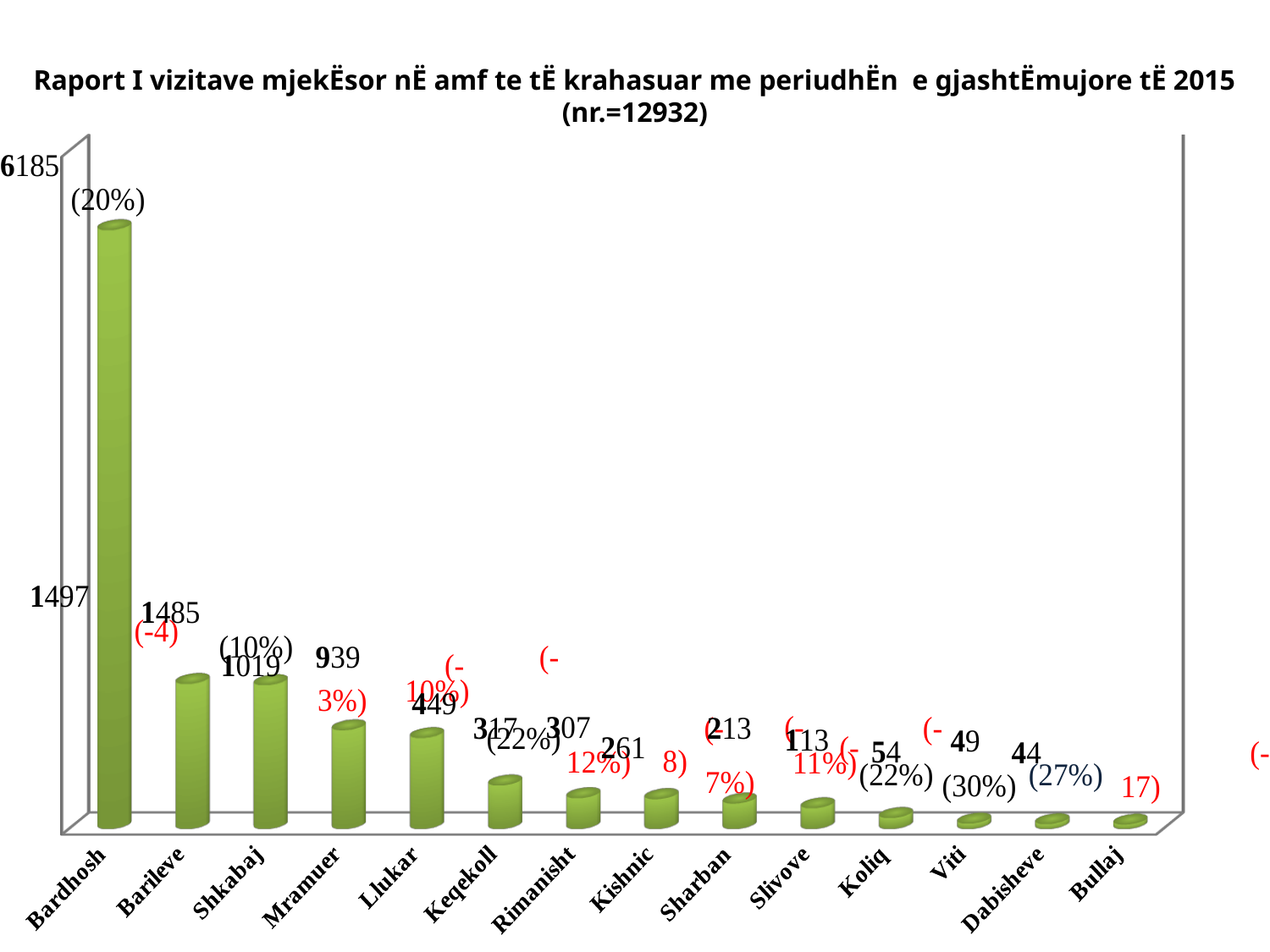
Which is larger, the value for Llukar or the value for Keqekoll? Llukar What is the value shown for Barileve? 1497 What percentage is shown in parentheses next to the Bardhosh bar? (20%) How many categories are shown on the x axis? 14 What is the value shown for Mramuer? 1019 What is the value shown for Shkabaj? 1485 What is the value shown for Sharban? 261 What is the difference between the values for Bardhosh and Barileve? 4688 What is the value shown for Bardhosh? 6185 Which category has the highest value? Bardhosh What total number is given in the chart title? nr.=12932 What type of chart is shown on the slide? bar chart